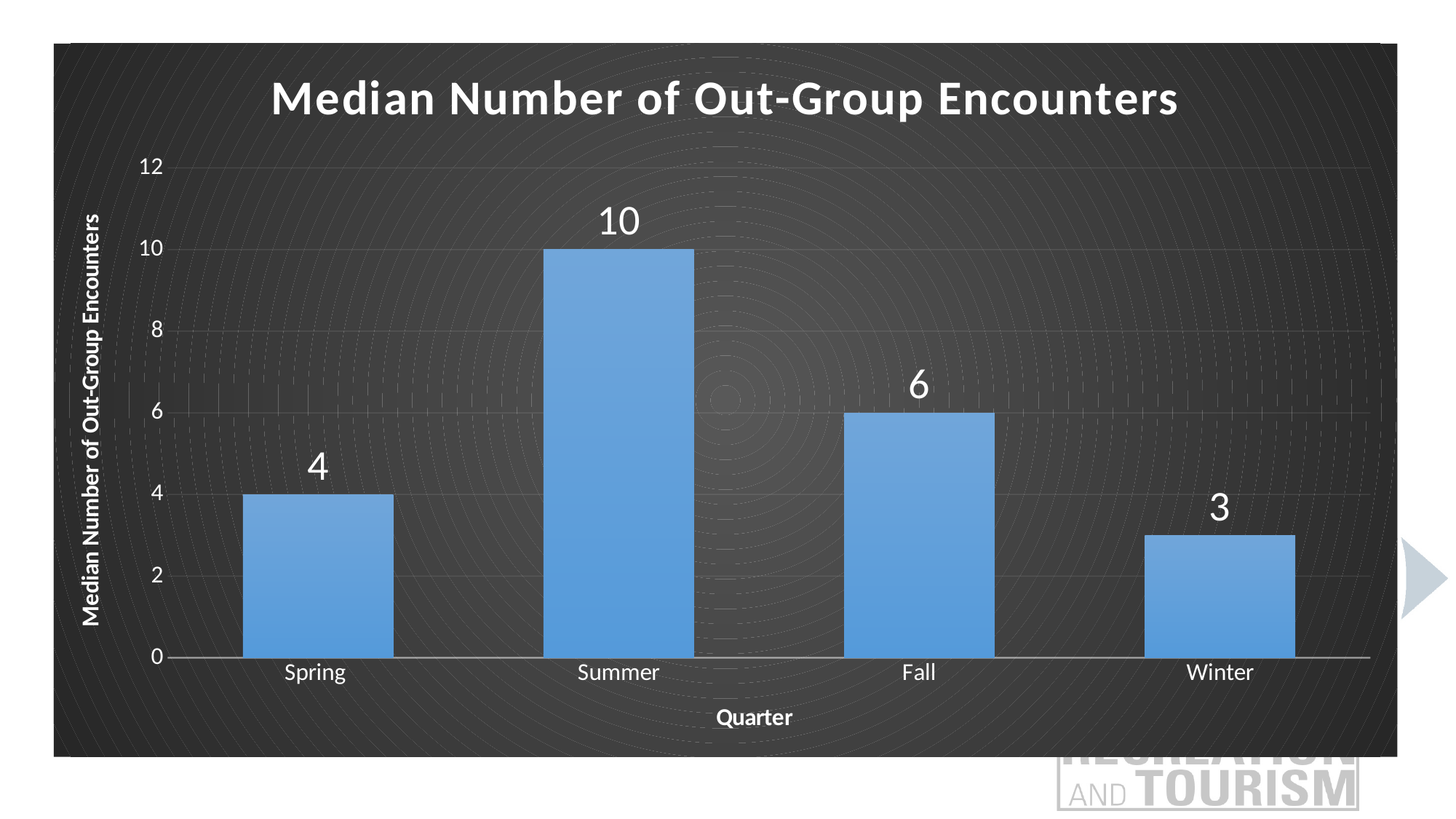
What is the median number of out-group encounters for Summer? 10 What is the difference between the median number of out-group encounters in Summer and Fall? 4 What is the median number of out-group encounters for Winter? 3 What is the difference between the median number of out-group encounters in Spring and Winter? 1 Is the value for Summer greater or less than 8? greater What is the title of the chart? Median Number of Out-Group Encounters Which quarter has a larger median number of out-group encounters, Fall or Spring? Fall Which quarter has the highest median number of out-group encounters? Summer What is the median number of out-group encounters for Spring? 4 Which quarter has the lowest median number of out-group encounters? Winter What kind of chart is shown on the slide? Bar chart How many quarters are shown on the x axis? 4